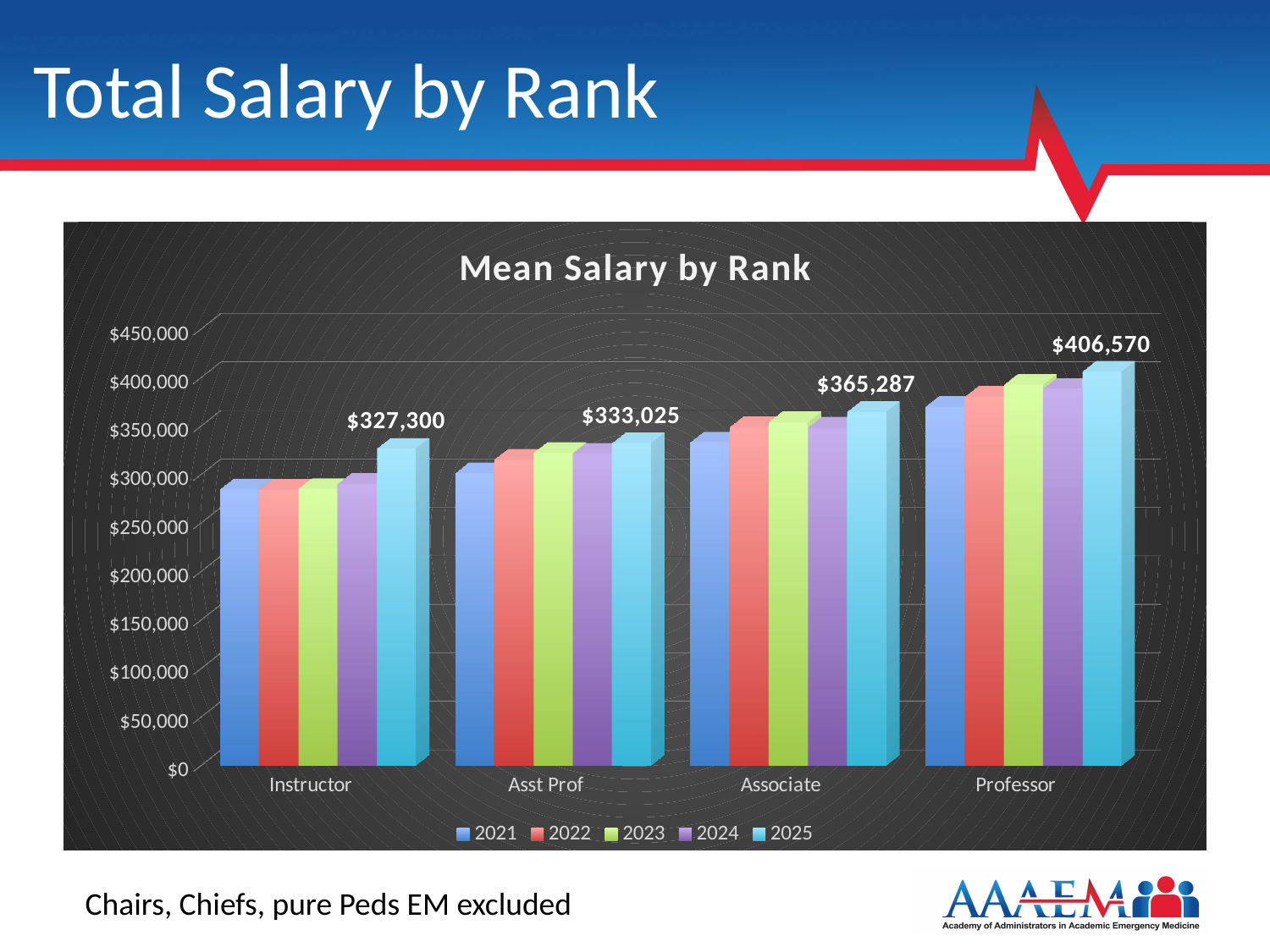
What is the difference between the 2025 mean salary for Professor and for Instructor? $79,270 What is the 2025 mean salary for Instructor? $327,300 Which rank has the lowest 2025 mean salary? Instructor What is the 2025 mean salary for Professor? $406,570 How many series does the legend list? 5 How many ranks are shown on the x axis? 4 Which has the larger 2025 mean salary, Associate or Asst Prof? Associate What kind of chart is shown? Bar chart Is the 2021 mean salary for Professor greater or less than $350,000? greater What is the 2025 mean salary for Asst Prof? $333,025 Which rank has the highest 2025 mean salary? Professor What is the 2025 mean salary for Associate? $365,287